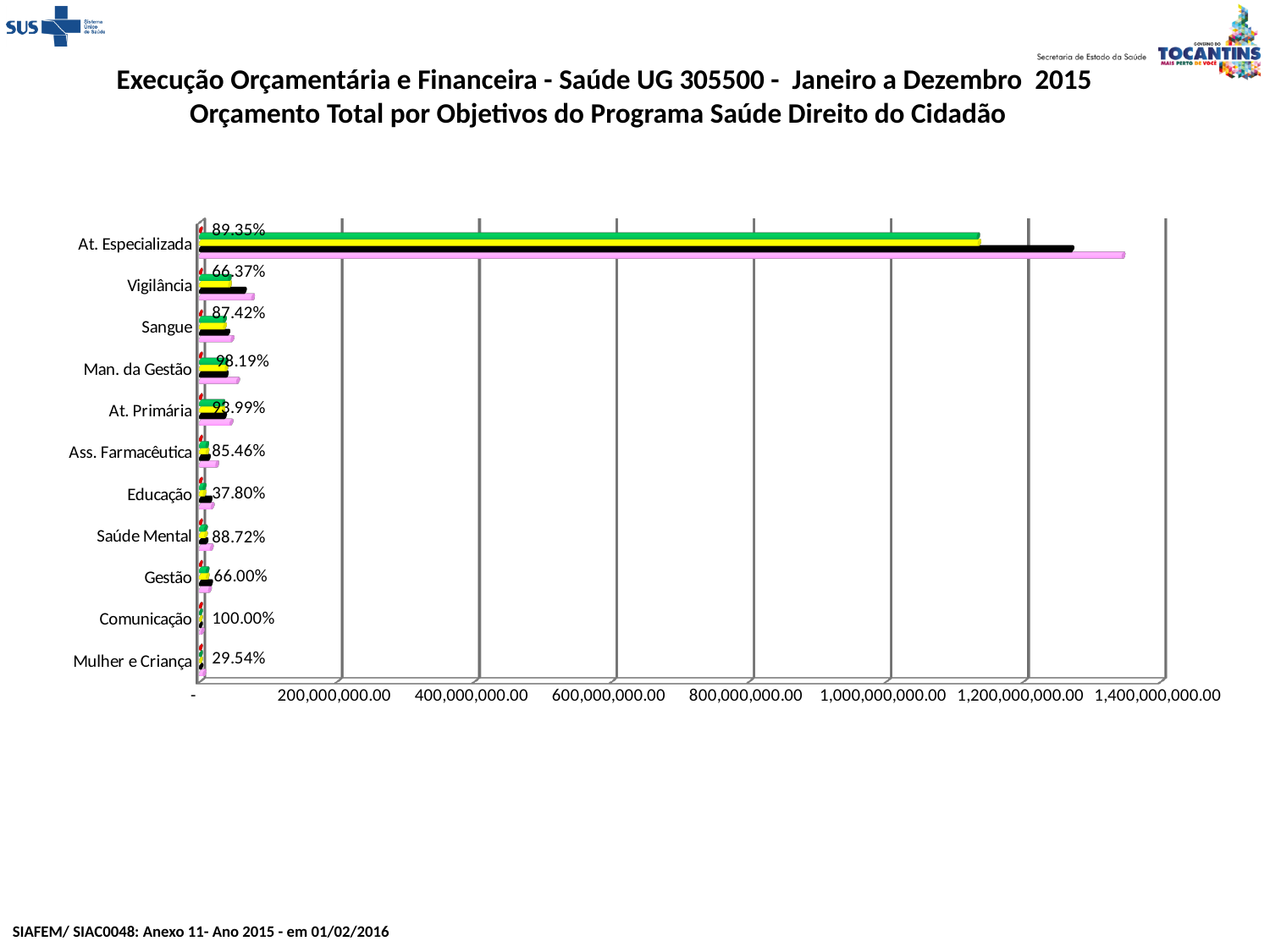
Which category has the lowest percentage label? Mulher e Criança Which has the larger percentage label, Gestão or Educação? Gestão How many categories are shown on the chart? 11 What kind of chart is shown on the slide? Bar chart Which category has the highest percentage label? Comunicação What percentage is shown for At. Especializada? 89.35% Is the value of the longest bar for Vigilância greater or less than 200,000,000.00? less Which category has the longest bars on the chart? At. Especializada What is the difference between the percentage labels for Comunicação and Mulher e Criança? 70.46% What percentage is shown for Man. da Gestão? 98.19% What percentage is shown for Educação? 37.80% Is the value of the longest bar for At. Especializada greater or less than 1,200,000,000.00? greater